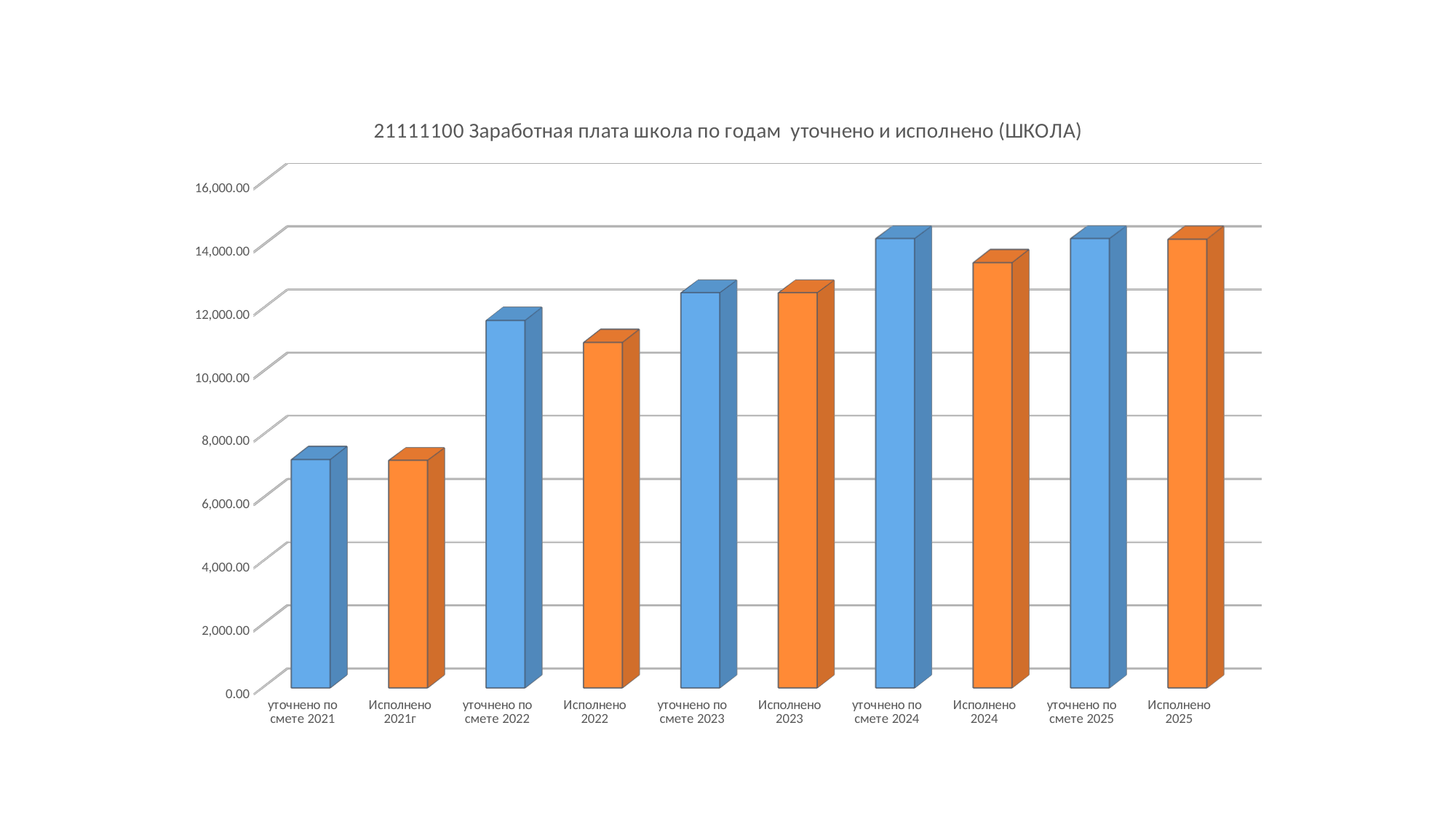
Is the value for "Исполнено 2024" greater or less than 12,000.00? greater What is the title of the chart? 21111100 Заработная плата школа по годам уточнено и исполнено (ШКОЛА) Is the value for "уточнено по смете 2021" greater or less than 8,000.00? less Is the value for "Исполнено 2021г" greater or less than 8,000.00? less Which is larger, the value for "уточнено по смете 2024" or "Исполнено 2024"? уточнено по смете 2024 Do the values generally rise or fall from 2021 to 2025 along the x axis? rise What kind of chart is shown on the slide? bar chart How many bars (categories) are plotted in the chart? 10 Which is larger, the value for "уточнено по смете 2022" or "Исполнено 2022"? уточнено по смете 2022